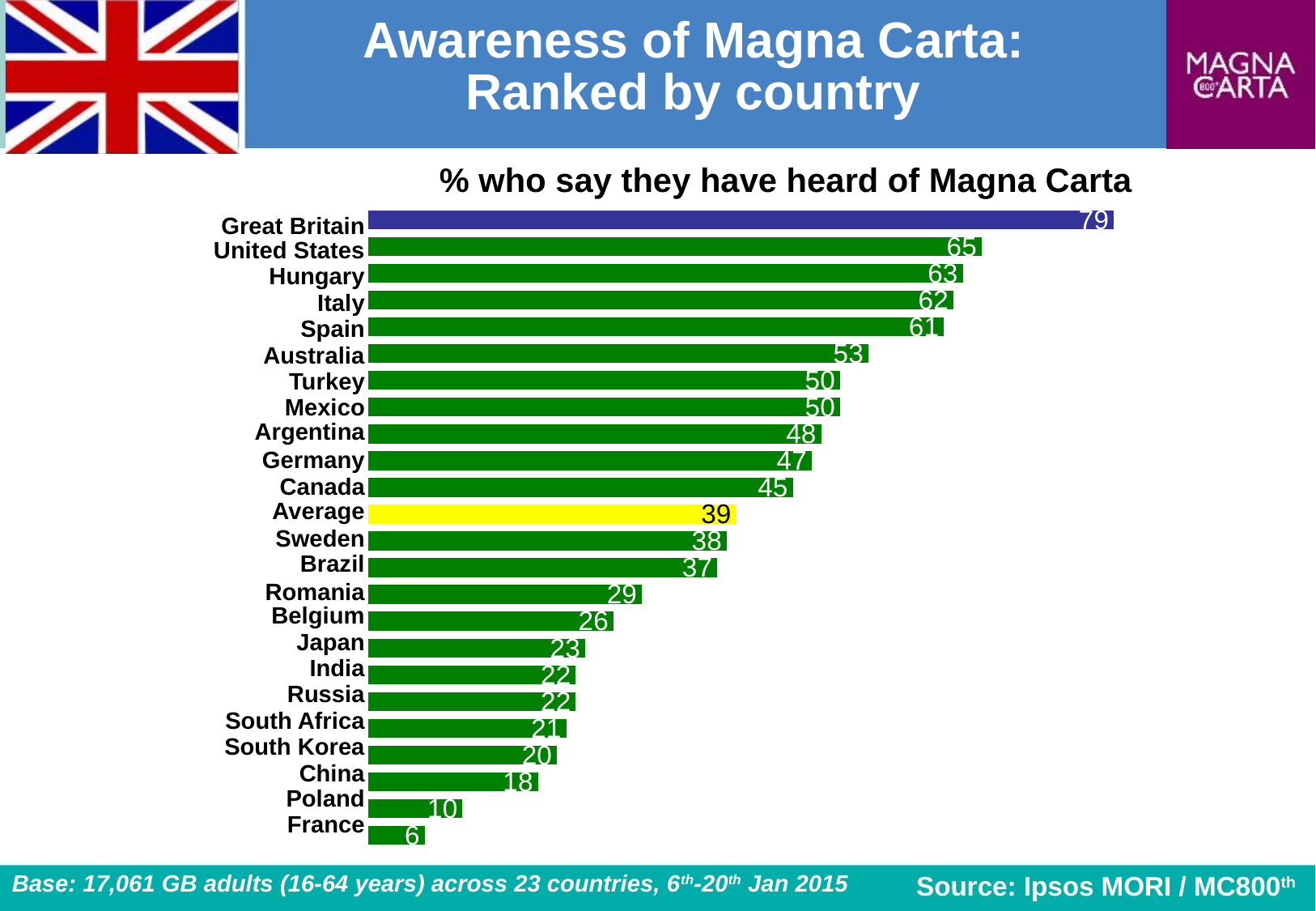
What is the difference between the values for Great Britain and the United States? 14 Which has a larger value, Poland or China? China Which country has the lowest value? France What is the difference between the values for Canada and Sweden? 7 What is the value for Great Britain? 79 What is the value shown for the Average bar? 39 What kind of chart is shown on the slide? Bar chart What is the value for Germany? 47 What colour is the Average bar? Yellow Which country has the highest value? Great Britain How many bars are plotted in the chart, including the Average bar? 24 Which has a larger value, Australia or Romania? Australia